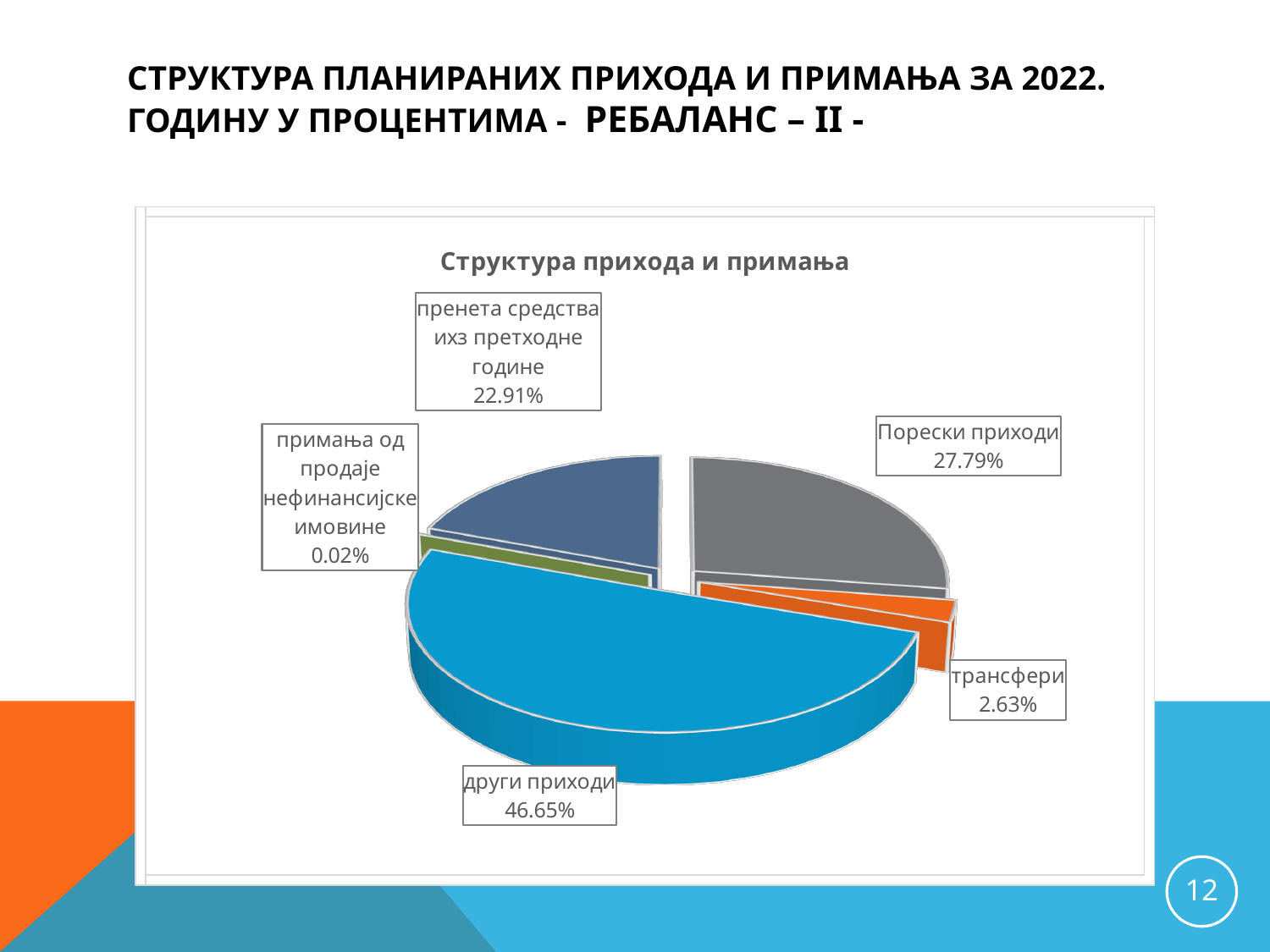
Which is larger, the share for "Порески приходи" or the share for "пренета средства ихз претходне године"? Порески приходи What kind of chart is shown on the slide? pie chart What share of the pie is labelled "пренета средства ихз претходне године"? 22.91% What is the title of the chart? Структура прихода и примања How many slices does the pie chart have? 5 What share of the pie is labelled "трансфери"? 2.63% Which category has the largest share of the pie? други приходи What share of the pie is labelled "други приходи"? 46.65% What is the difference in percentage points between the share for "други приходи" and the share for "Порески приходи"? 18.86 Which category has the smallest share of the pie? примања од продаје нефинансијске имовине